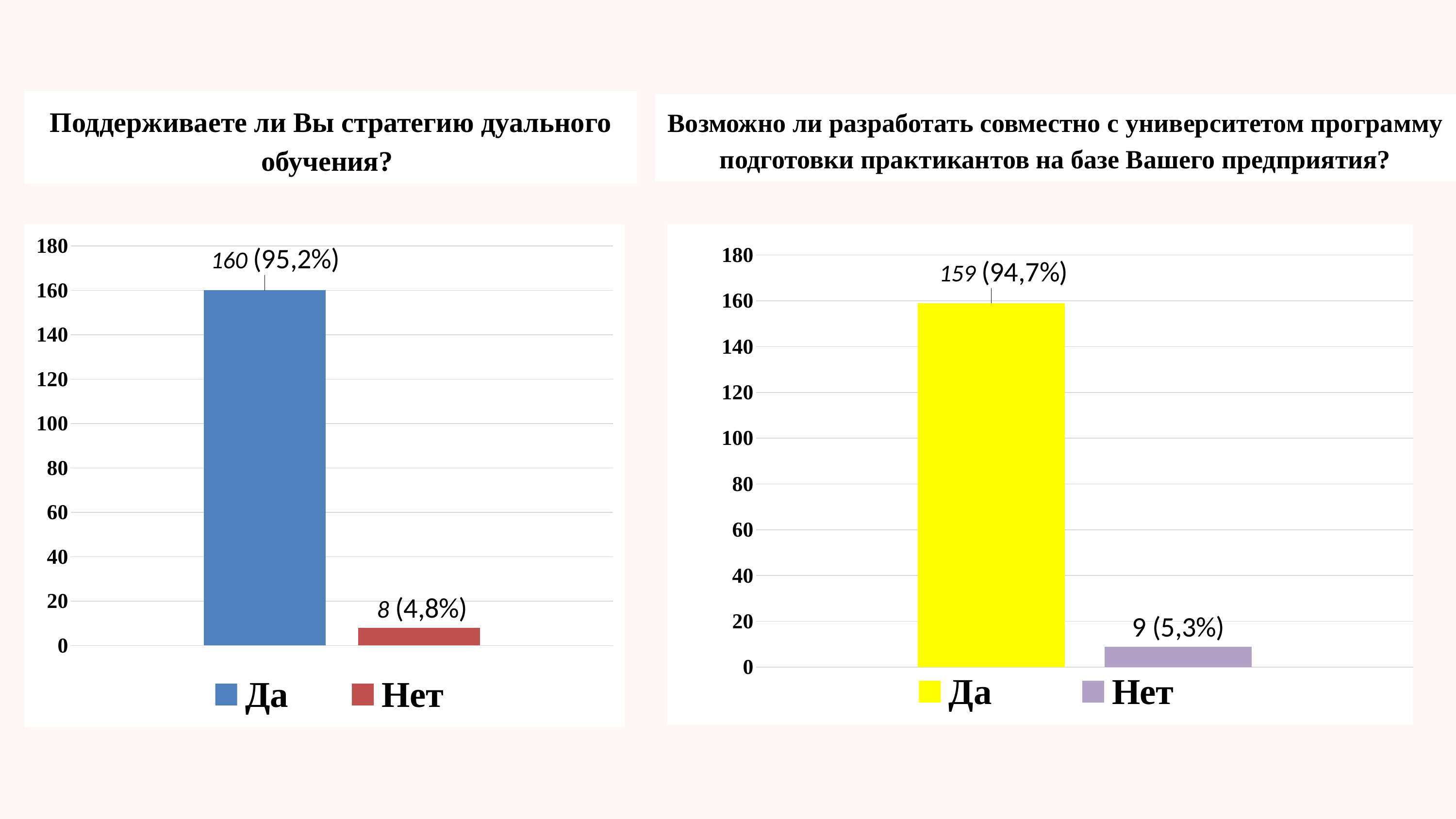
What kind of chart is the left chart? Bar chart In the left chart, what is the difference between the counts for "Да" and "Нет"? 152 In the left chart ("Поддерживаете ли Вы стратегию дуального обучения?"), what is the value for "Нет"? 8 (4,8%) In the right chart, which category has the lowest value? Нет In the right chart, is the value for "Да" greater or less than 140? greater In the right chart, what is the difference between the counts for "Да" and "Нет"? 150 Which is larger: the count for "Да" in the left chart or the count for "Да" in the right chart? Left chart (160) In the left chart ("Поддерживаете ли Вы стратегию дуального обучения?"), what is the value for "Да"? 160 (95,2%) How many entries does the legend of the right chart list? 2 In the left chart, which category has the highest value? Да In the right chart ("Возможно ли разработать совместно с университетом программу..."), what is the value for "Нет"? 9 (5,3%) In the right chart ("Возможно ли разработать совместно с университетом программу..."), what is the value for "Да"? 159 (94,7%)